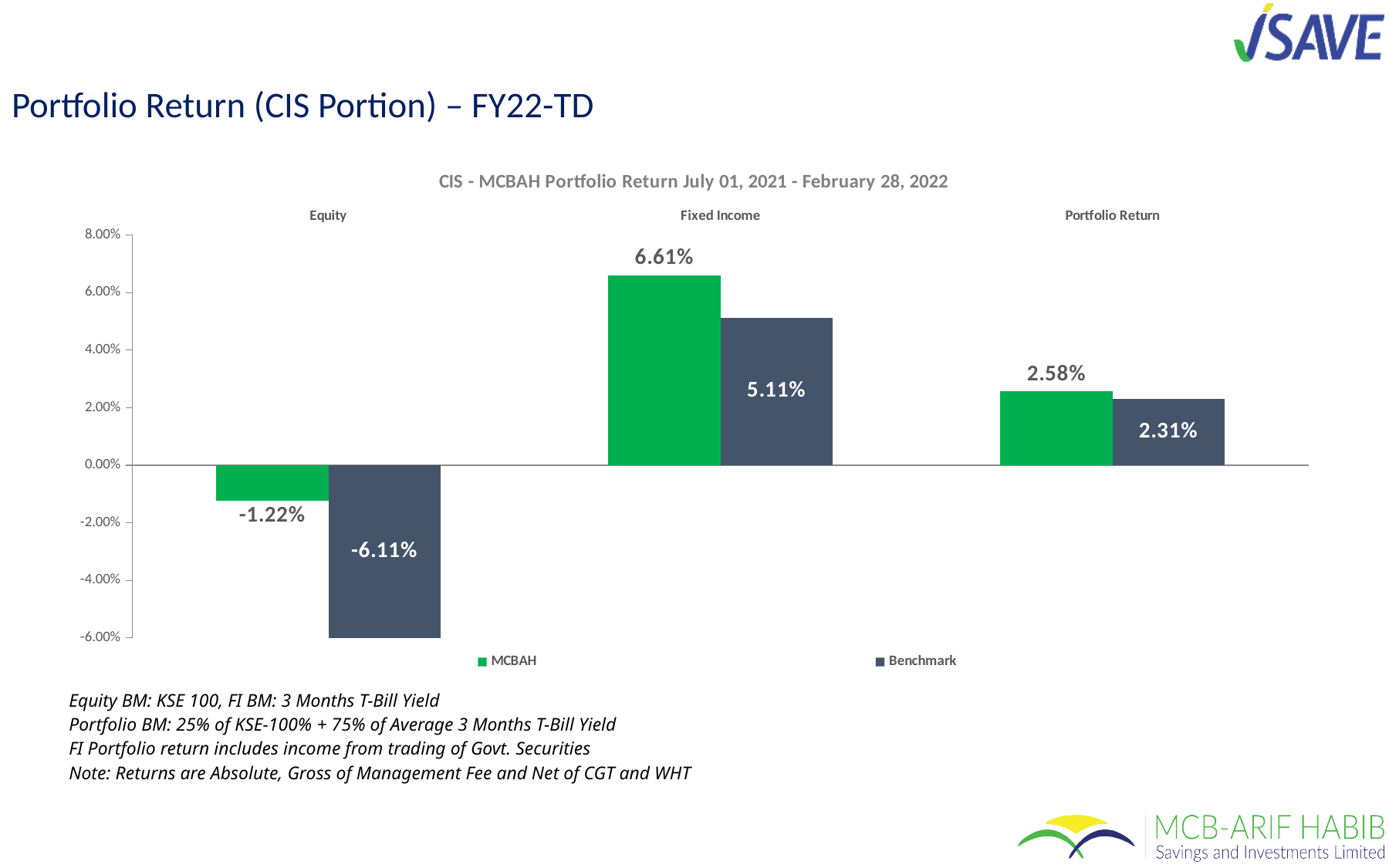
What kind of chart is shown on the slide? Bar chart What is the MCBAH value for Portfolio Return? 2.58% How many series does the legend list? 2 What is the Benchmark return for Equity? -6.11% What is the difference between the MCBAH and Benchmark returns for Fixed Income? 1.50% Which is larger for Equity, the MCBAH return or the Benchmark return? MCBAH Which category has the lowest Benchmark return? Equity Which category has the highest MCBAH return? Fixed Income What is the MCBAH return for Fixed Income? 6.61% What is the Benchmark value for Portfolio Return? 2.31% How many categories are shown on the x axis? 3 What is the title of the chart? CIS - MCBAH Portfolio Return July 01, 2021 - February 28, 2022